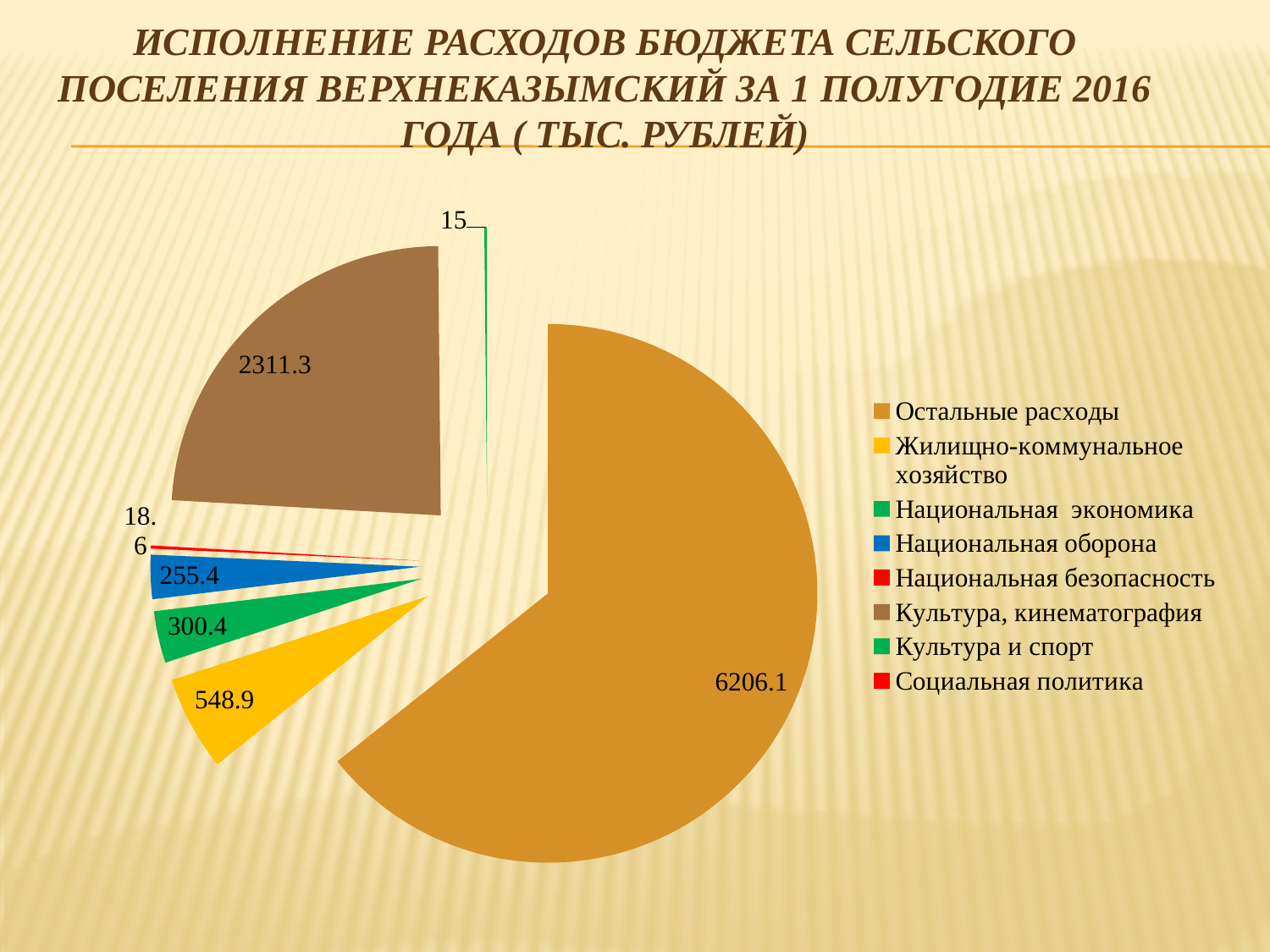
Which is larger, Национальная экономика or Национальная оборона? Национальная экономика What is the difference between Жилищно-коммунальное хозяйство and Национальная экономика? 248.5 How many categories does the legend list? 8 What is the value for Культура, кинематография? 2311.3 What colour is the slice for Культура, кинематография? brown What is the value for Национальная экономика? 300.4 What is the value for Остальные расходы? 6206.1 What is the difference between Остальные расходы and Культура, кинематография? 3894.8 What type of chart is shown on the slide? pie chart Which category has the largest slice of the pie? Остальные расходы What is the value for Жилищно-коммунальное хозяйство? 548.9 What is the value for Национальная оборона? 255.4